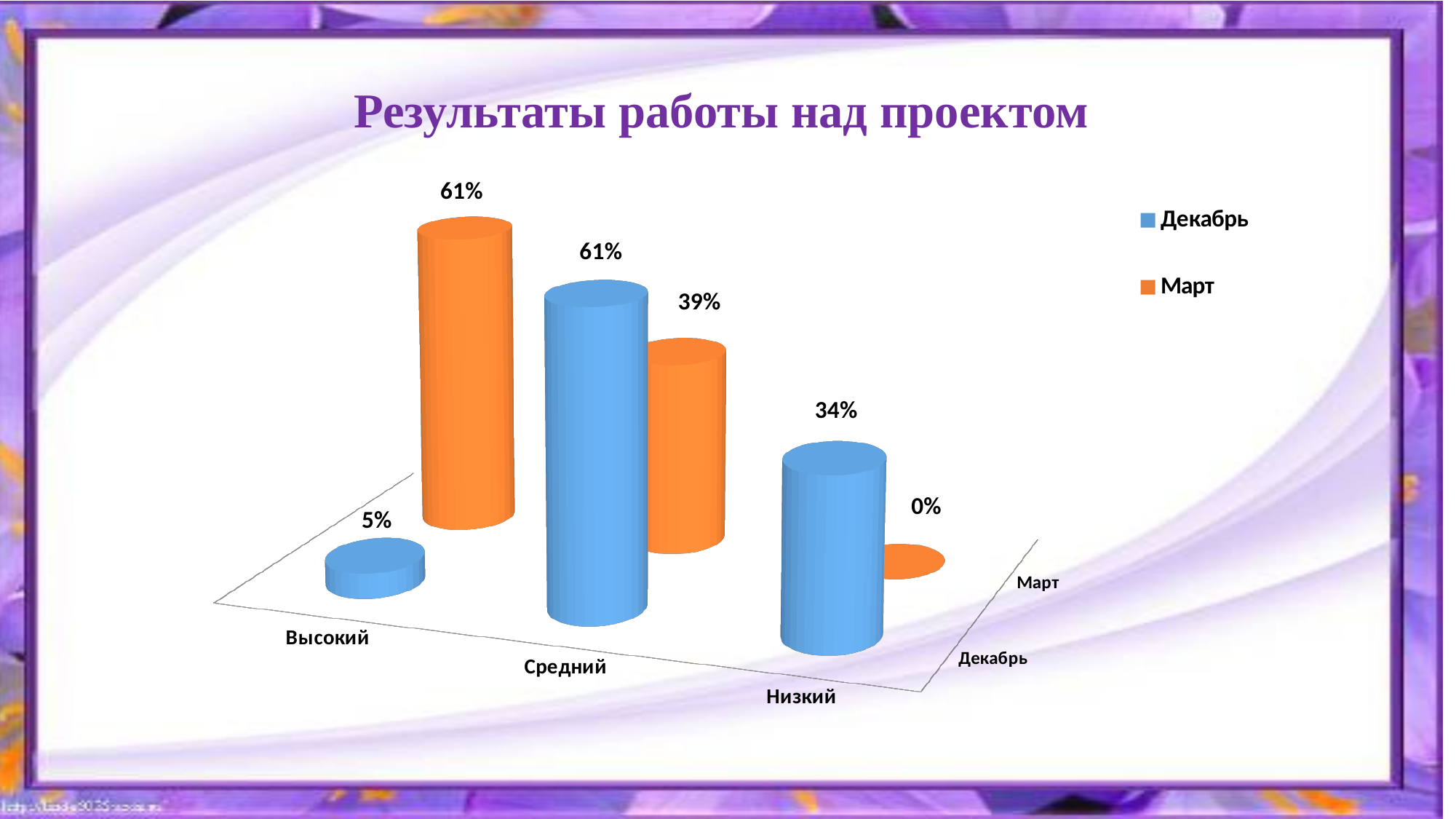
Which category has the lowest value in the Март series? Низкий What is the value for Средний in the Март series? 39% What is the value for Высокий in the Декабрь series? 5% How many series does the legend list? 2 What is the difference between the Март and Декабрь values for Высокий? 56% What is the value for Высокий in the Март series? 61% Which category has the highest value in the Декабрь series? Средний What is the title of the slide? Результаты работы над проектом What is the value for Низкий in the Март series? 0% How many categories are shown on the chart? 3 For Средний, which series has the larger value, Декабрь or Март? Декабрь What is the value for Низкий in the Декабрь series? 34%